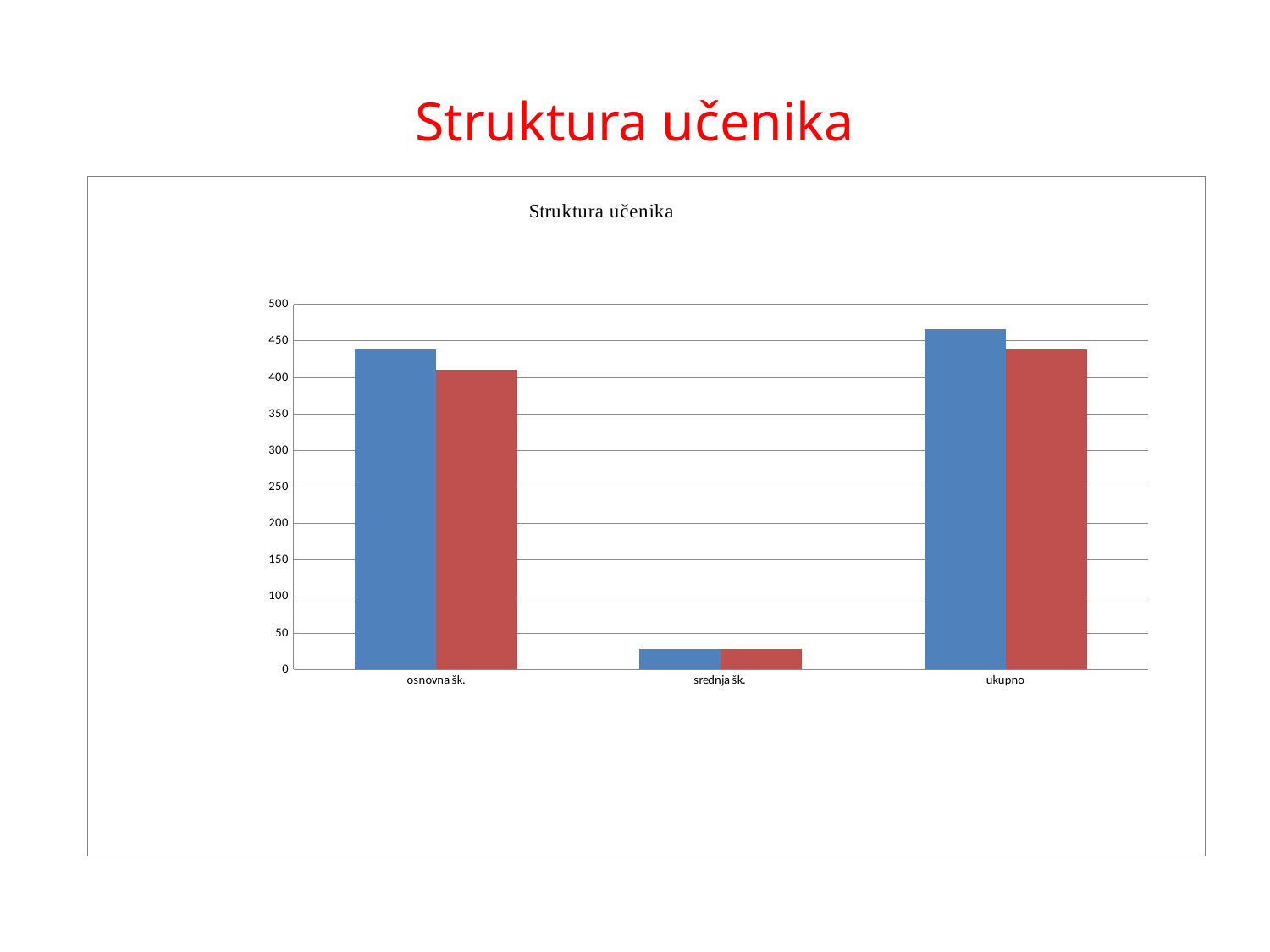
Which category has the lowest values in the chart? srednja šk. Is the blue bar for osnovna šk. greater or less than 400? greater Is the blue bar for ukupno greater or less than 450? greater Which is larger, the blue bar for ukupno or the blue bar for osnovna šk.? ukupno Which category has the tallest blue bar in the chart? ukupno What kind of chart is shown on the slide? bar chart For osnovna šk., which bar is taller, the blue one or the red one? blue How many categories are shown on the x axis of the chart? 3 Is the red bar for ukupno greater or less than 400? greater What is the title of the chart? Struktura učenika How many bars are shown for each category in the chart? 2